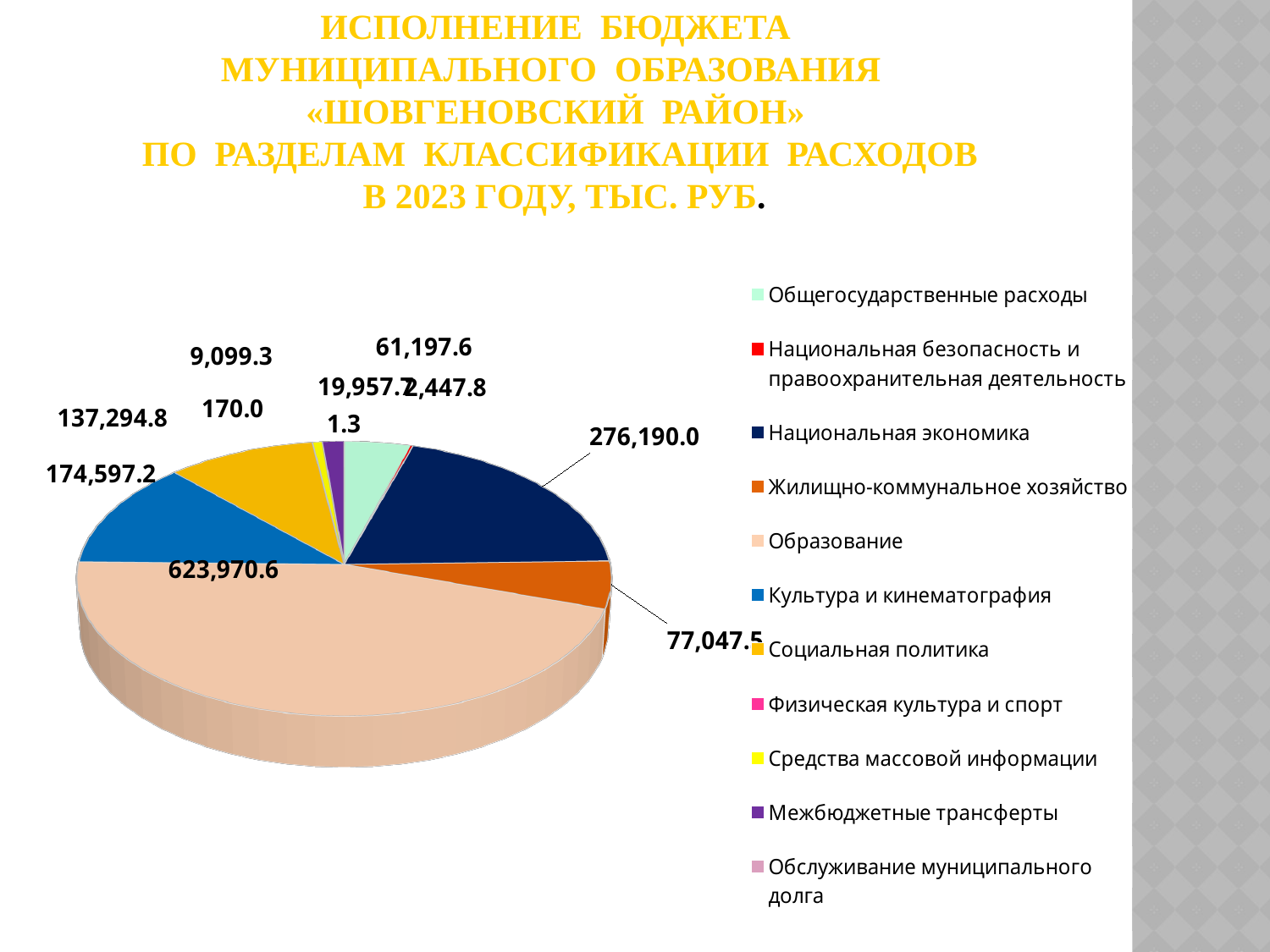
What is the value for Общегосударственные расходы? 61,197.6 Which category has the largest share of the pie? Образование What is the value for Образование? 623,970.6 What is the value for Национальная экономика? 276,190.0 How many categories does the legend list? 11 Which is larger, the value for Культура и кинематография or the value for Социальная политика? Культура и кинематография What is the difference between the values for Национальная экономика and Жилищно-коммунальное хозяйство? 199,142.5 In what year and units are the budget expenditures shown, according to the title? 2023, тыс. руб. What is the value for Жилищно-коммунальное хозяйство? 77,047.5 What is the value for Социальная политика? 137,294.8 What is the value for Культура и кинематография? 174,597.2 What type of chart is shown on the slide? Pie chart